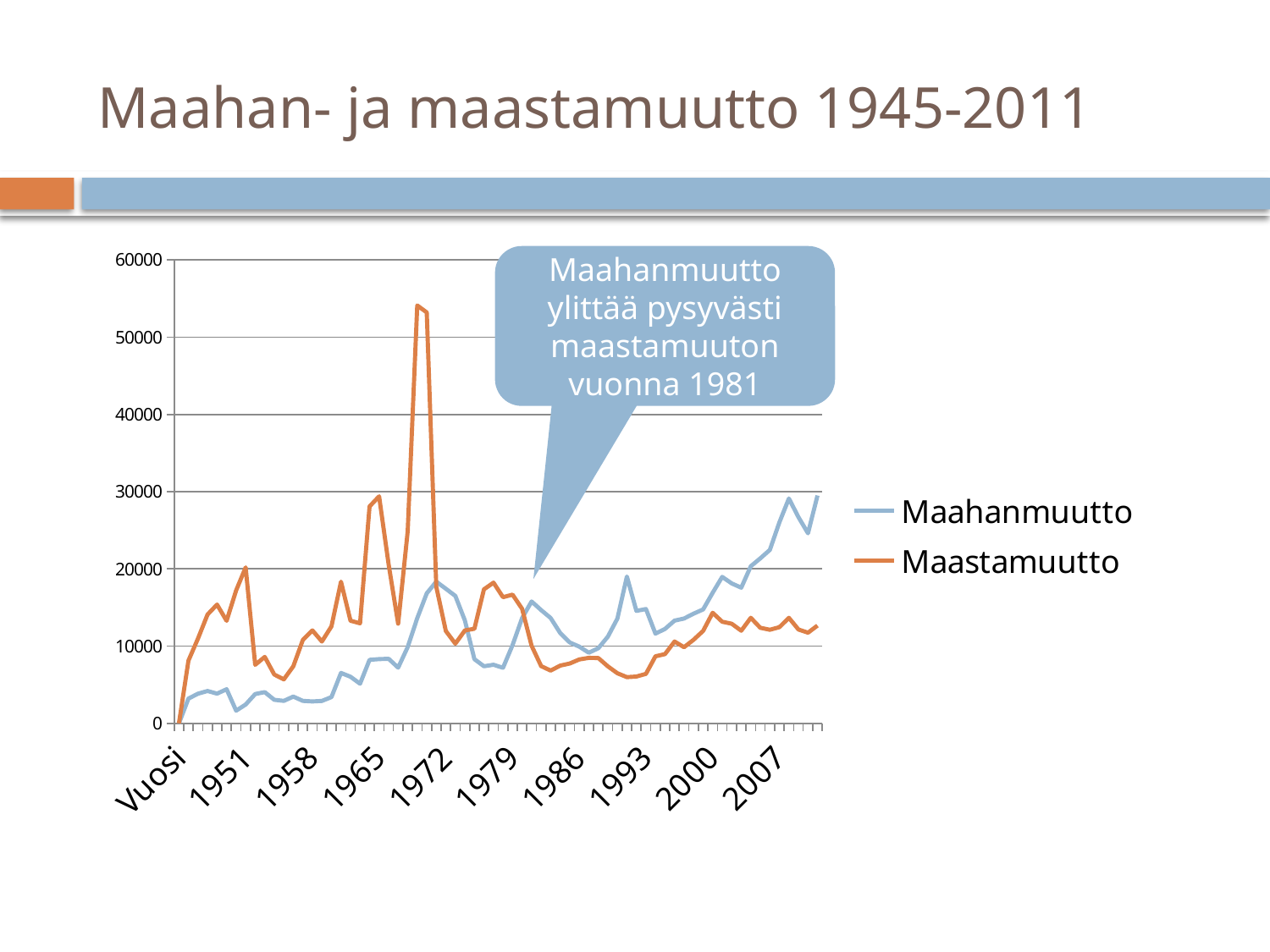
What kind of chart is shown on the slide? line chart In 2007, which series has the higher value, Maahanmuutto or Maastamuutto? Maahanmuutto Is the value of Maahanmuutto in 2007 greater or less than 20000? greater Which series reaches the highest value anywhere on the chart? Maastamuutto Is the value of Maastamuutto in 1993 greater or less than 10000? less What are the two series named in the legend? Maahanmuutto and Maastamuutto Does the Maahanmuutto line generally rise or fall between 1993 and 2007? rise Is the value of Maahanmuutto in 1951 greater or less than 10000? less How many series does the legend list? 2 In 1965, which series has the higher value, Maahanmuutto or Maastamuutto? Maastamuutto According to the callout on the chart, in which year does Maahanmuutto permanently exceed Maastamuutto? 1981